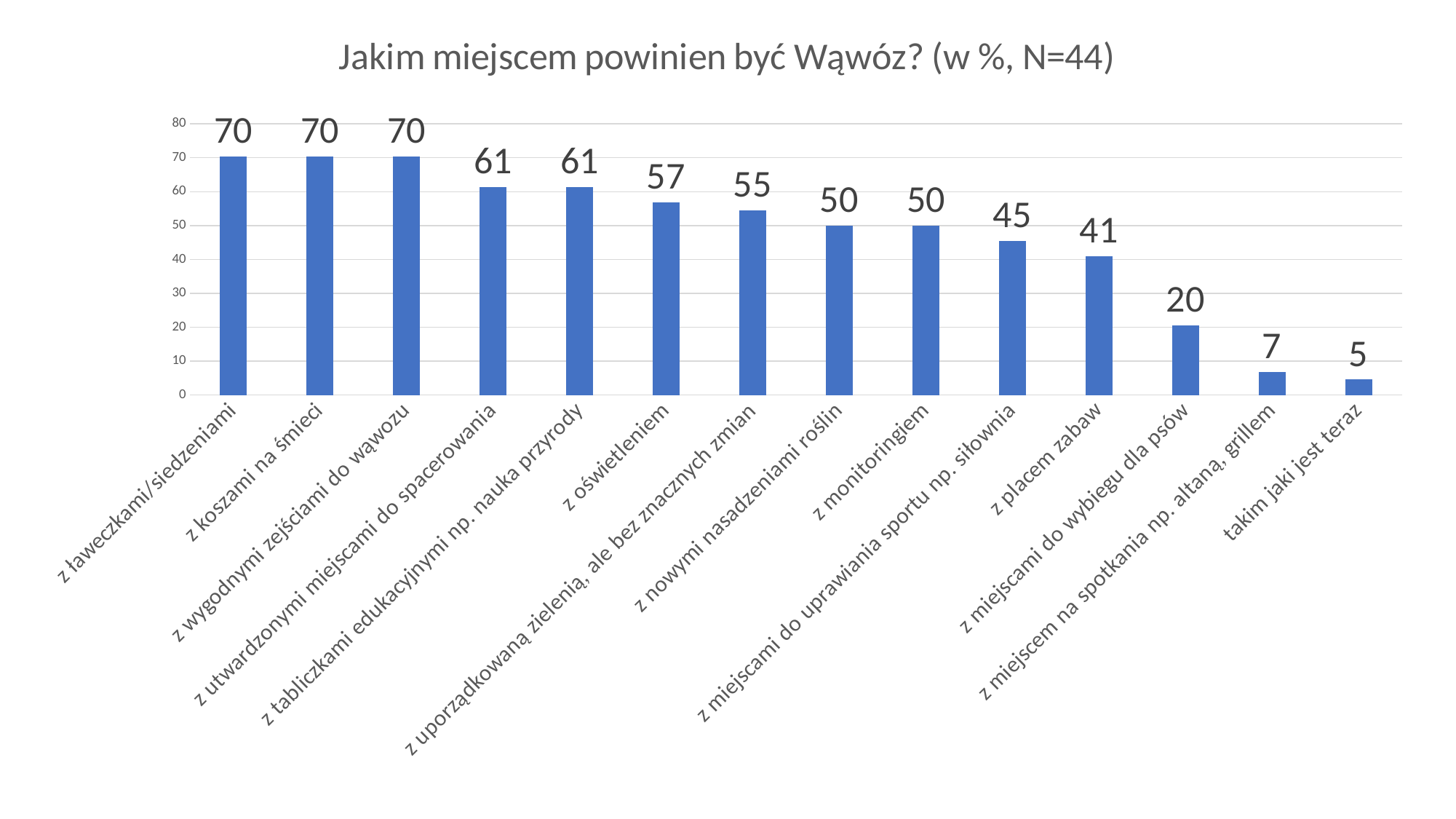
What is the difference between the values for "z koszami na śmieci" and "z placem zabaw"? 29 What kind of chart is shown on the slide? bar chart What is the highest value shown on the chart? 70 What is the title of the chart? Jakim miejscem powinien być Wąwóz? (w %, N=44) What is the value for "z oświetleniem"? 57 What is the value for "z monitoringiem"? 50 What is the value for "z placem zabaw"? 41 What is the value for "z miejscami do wybiegu dla psów"? 20 How many categories are shown on the chart? 14 Is the value for "z miejscem na spotkania np. altaną, grillem" greater or less than 10? less Which is larger: the value for "z uporządkowaną zielenią, ale bez znacznych zmian" or the value for "z miejscami do uprawiania sportu np. siłownia"? z uporządkowaną zielenią, ale bez znacznych zmian Which category has the lowest value? takim jaki jest teraz